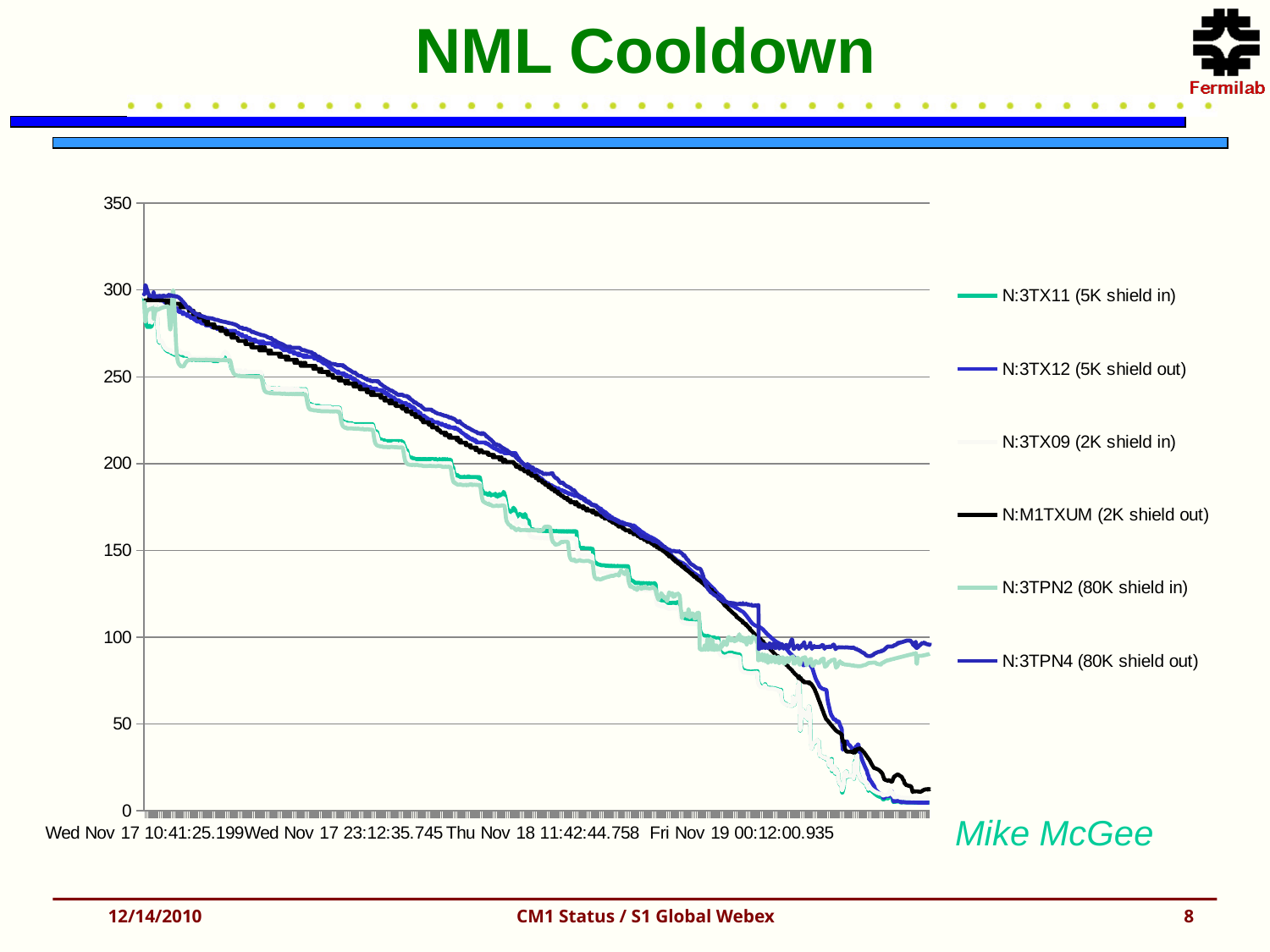
What kind of chart is shown on the slide? line chart How many timestamp labels are shown along the x axis? 4 At the right end of the chart, which is larger, N:3TPN4 (80K shield out) or N:3TX12 (5K shield out)? N:3TPN4 (80K shield out) Do the plotted values generally rise or fall along the x axis? fall At the left end of the chart, is the value for N:3TX12 (5K shield out) greater or less than 250? greater At the right end of the chart, is the value for N:3TPN2 (80K shield in) greater or less than 100? less What is the highest tick value shown on the y axis? 350 How many series does the legend list? 6 Which legend entry is labelled as the 2K shield out sensor? N:M1TXUM (2K shield out) At the right end of the chart, is the value for N:M1TXUM (2K shield out) greater or less than 50? less